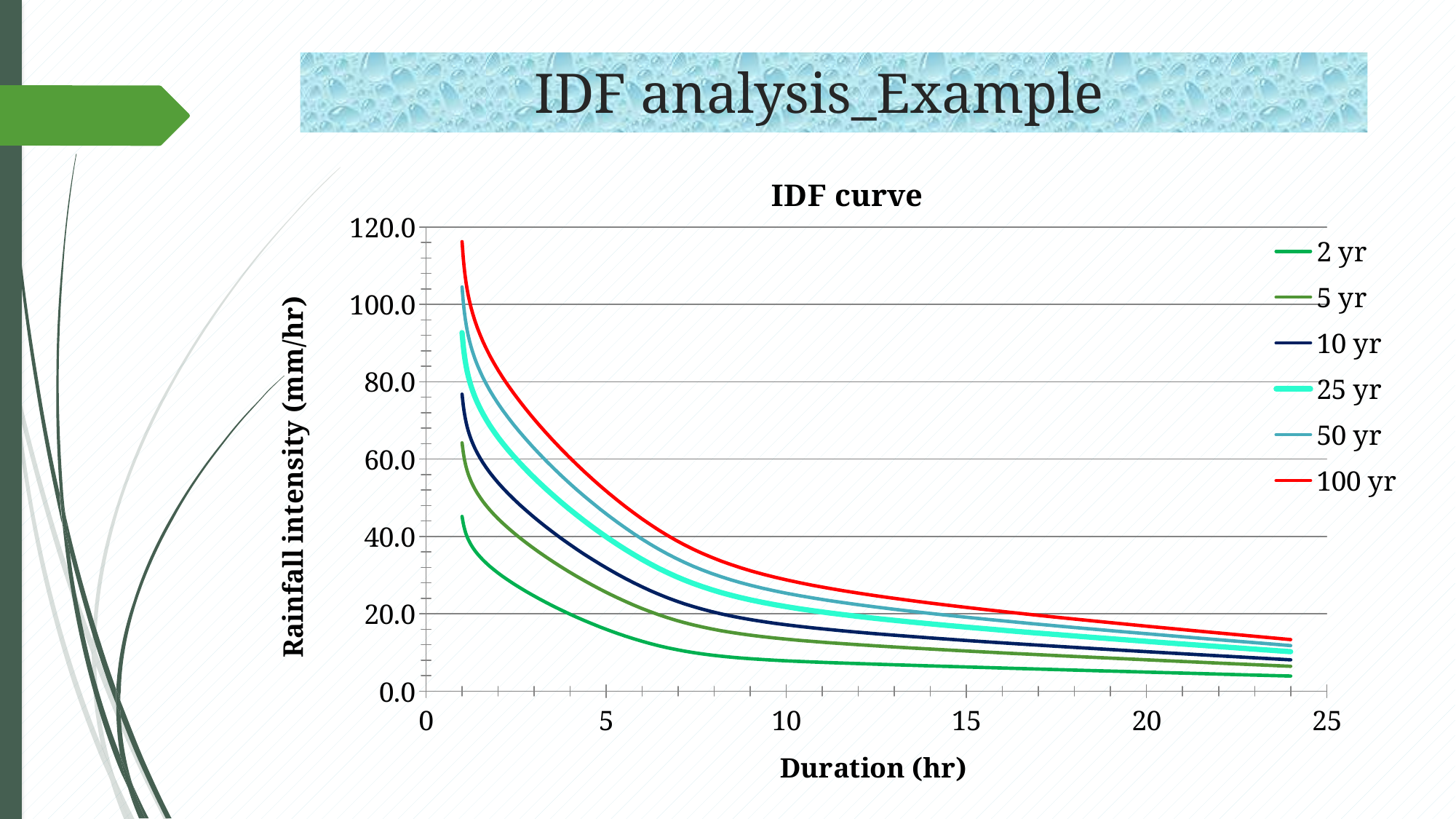
Which series has the highest rainfall intensity across all durations? 100 yr Is the value for the 2 yr series at a duration of 5 hr greater or less than 20.0? less Do the rainfall intensity values rise or fall as duration increases along the x axis? fall Is the value for the 100 yr series at a duration of 24 hr greater or less than 20.0? less At a duration of 10 hr, which series has the larger rainfall intensity, 50 yr or 5 yr? 50 yr Which series has the lowest rainfall intensity across all durations? 2 yr Is the value for the 10 yr series at a duration of 1 hr greater or less than 80.0? less What is the label of the vertical axis? Rainfall intensity (mm/hr) What kind of chart is shown on the slide? line chart What is the title of the chart? IDF curve How many series does the legend of the IDF curve chart list? 6